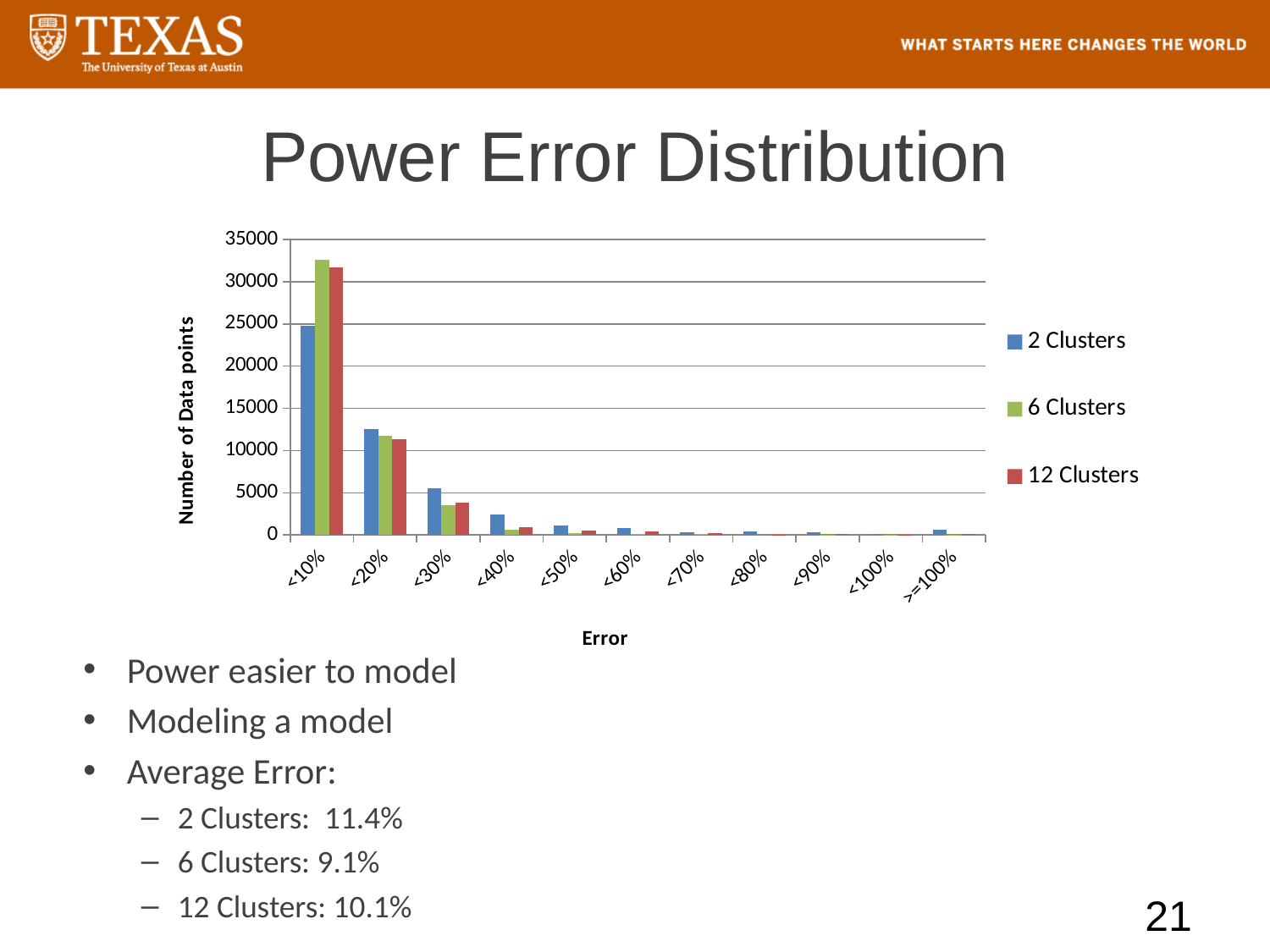
What kind of chart is shown on the slide? bar chart Is the value for 2 Clusters at <10% greater or less than 20000? greater How many error categories are shown on the x axis? 11 Do the values for the 2 Clusters series generally rise or fall as error increases along the x axis? fall Which series has the tallest bar in the <20% error category? 2 Clusters Is the value for 12 Clusters at <10% greater or less than 30000? greater How many series does the legend list? 3 What is the title of the y axis? Number of Data points In the <30% error category, which is larger: 2 Clusters or 6 Clusters? 2 Clusters Which error category has the highest number of data points for the 6 Clusters series? <10% Which series has the tallest bar in the <10% error category? 6 Clusters Is the value for 6 Clusters at <30% greater or less than 5000? less